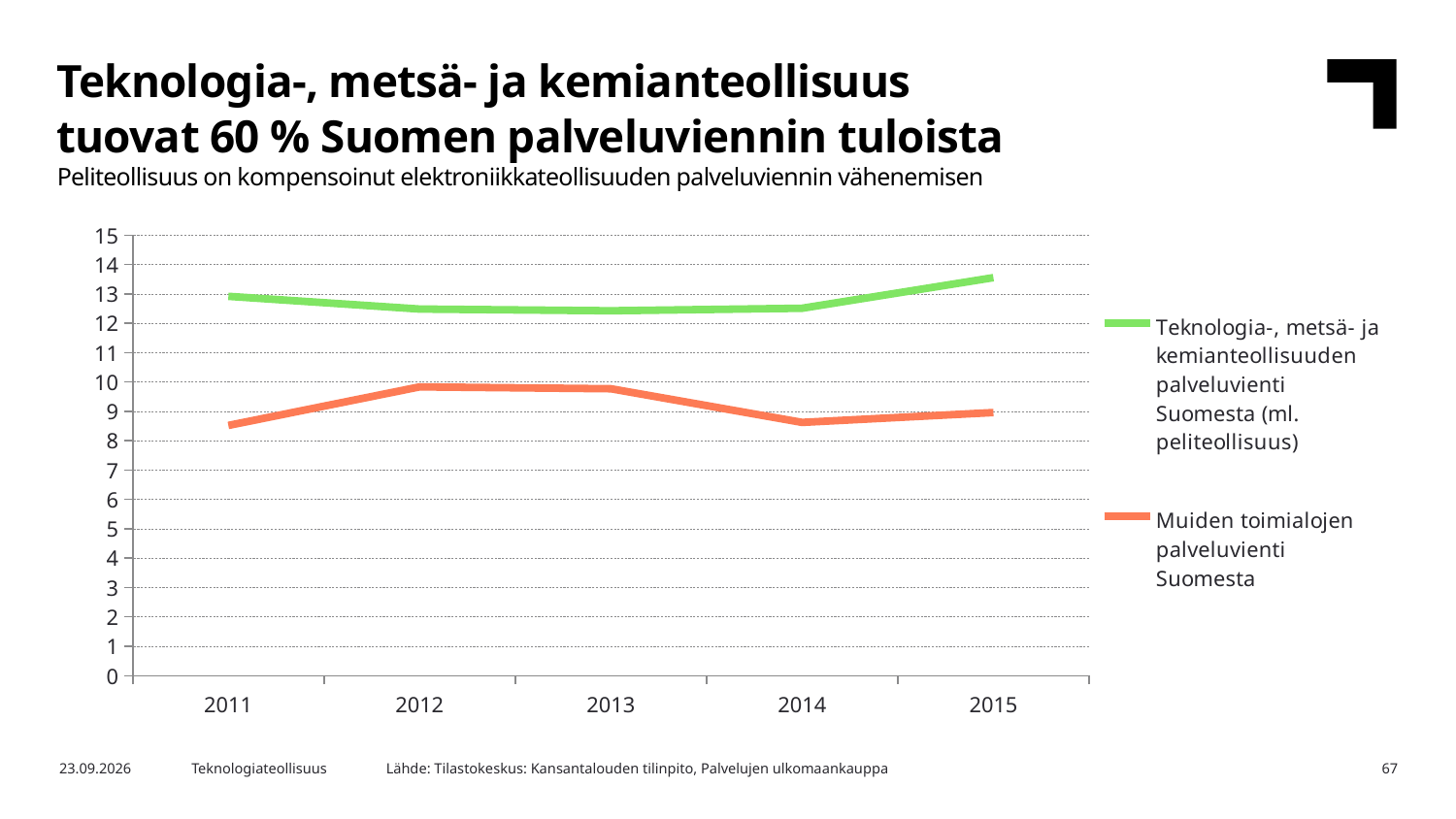
How many series does the legend list? 2 Does the value for Muiden toimialojen palveluvienti Suomesta rise or fall from 2011 to 2012? rise Which series has the larger value in 2013, Teknologia-, metsä- ja kemianteollisuuden palveluvienti Suomesta (ml. peliteollisuus) or Muiden toimialojen palveluvienti Suomesta? Teknologia-, metsä- ja kemianteollisuuden palveluvienti Suomesta (ml. peliteollisuus) What colour is the line for Muiden toimialojen palveluvienti Suomesta? orange Does the value for Teknologia-, metsä- ja kemianteollisuuden palveluvienti Suomesta (ml. peliteollisuus) rise or fall from 2014 to 2015? rise Is the value for Teknologia-, metsä- ja kemianteollisuuden palveluvienti Suomesta (ml. peliteollisuus) in 2015 greater or less than 13? greater What kind of chart is shown on the slide? line chart Is the value for Teknologia-, metsä- ja kemianteollisuuden palveluvienti Suomesta (ml. peliteollisuus) in 2013 greater or less than 13? less Is the value for Muiden toimialojen palveluvienti Suomesta in 2012 greater or less than 10? less How many years are shown on the x axis? 5 In which year is the value for Teknologia-, metsä- ja kemianteollisuuden palveluvienti Suomesta (ml. peliteollisuus) highest? 2015